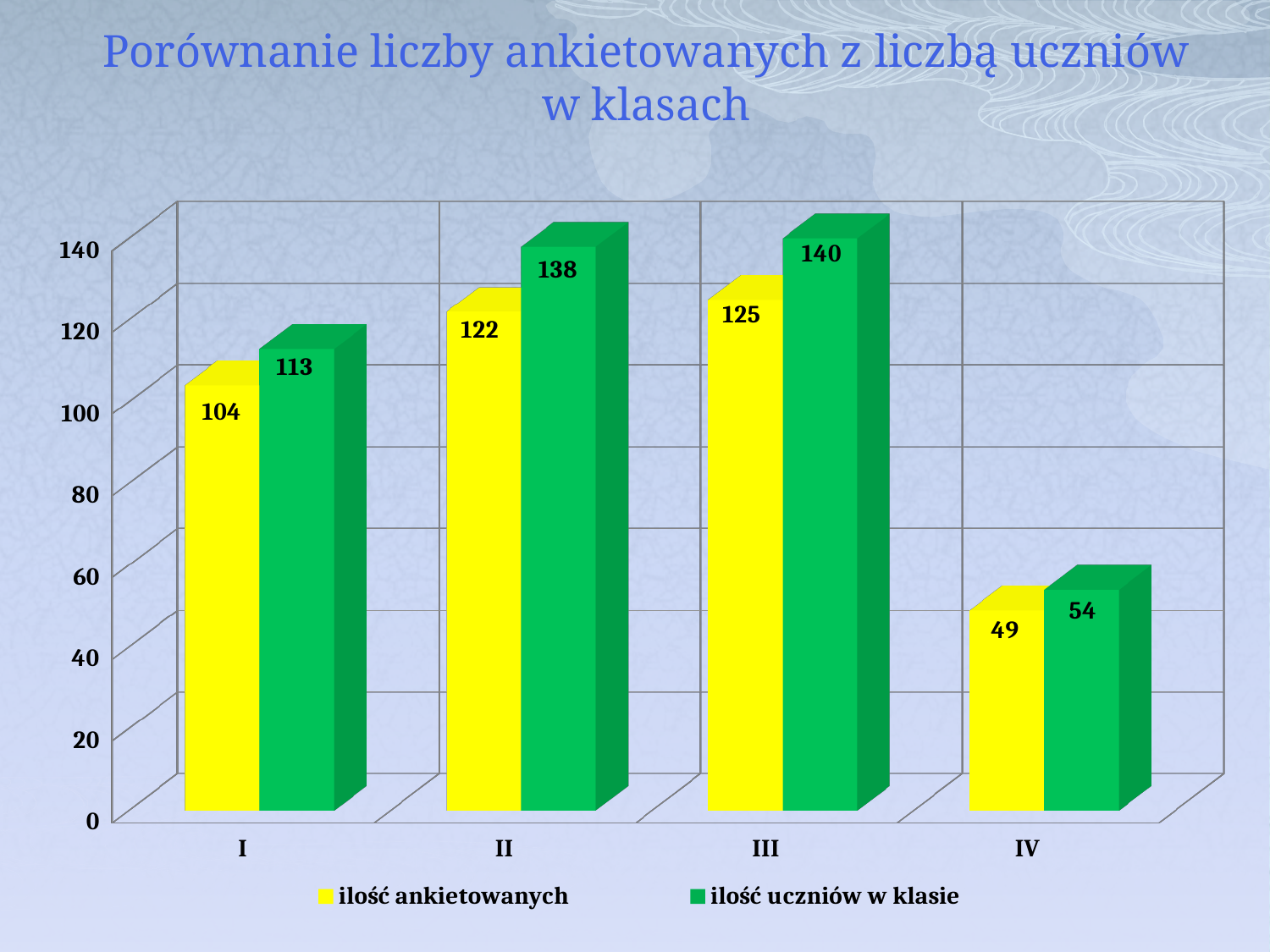
How many series does the legend list? 2 Which is larger: 'ilość ankietowanych' for class II or 'ilość ankietowanych' for class III? ilość ankietowanych for class III Which class has the lowest value for 'ilość ankietowanych'? IV Is the value of 'ilość uczniów w klasie' for class IV greater or less than 60? less What is the difference between 'ilość uczniów w klasie' and 'ilość ankietowanych' for class II? 16 What colour represents 'ilość uczniów w klasie' in the chart? green What is the value of 'ilość uczniów w klasie' for class III? 140 How many classes are shown on the x axis? 4 What is the value of 'ilość ankietowanych' for class I? 104 What kind of chart is shown on the slide? bar chart What is the value of 'ilość ankietowanych' for class IV? 49 Which class has the highest value for 'ilość uczniów w klasie'? III